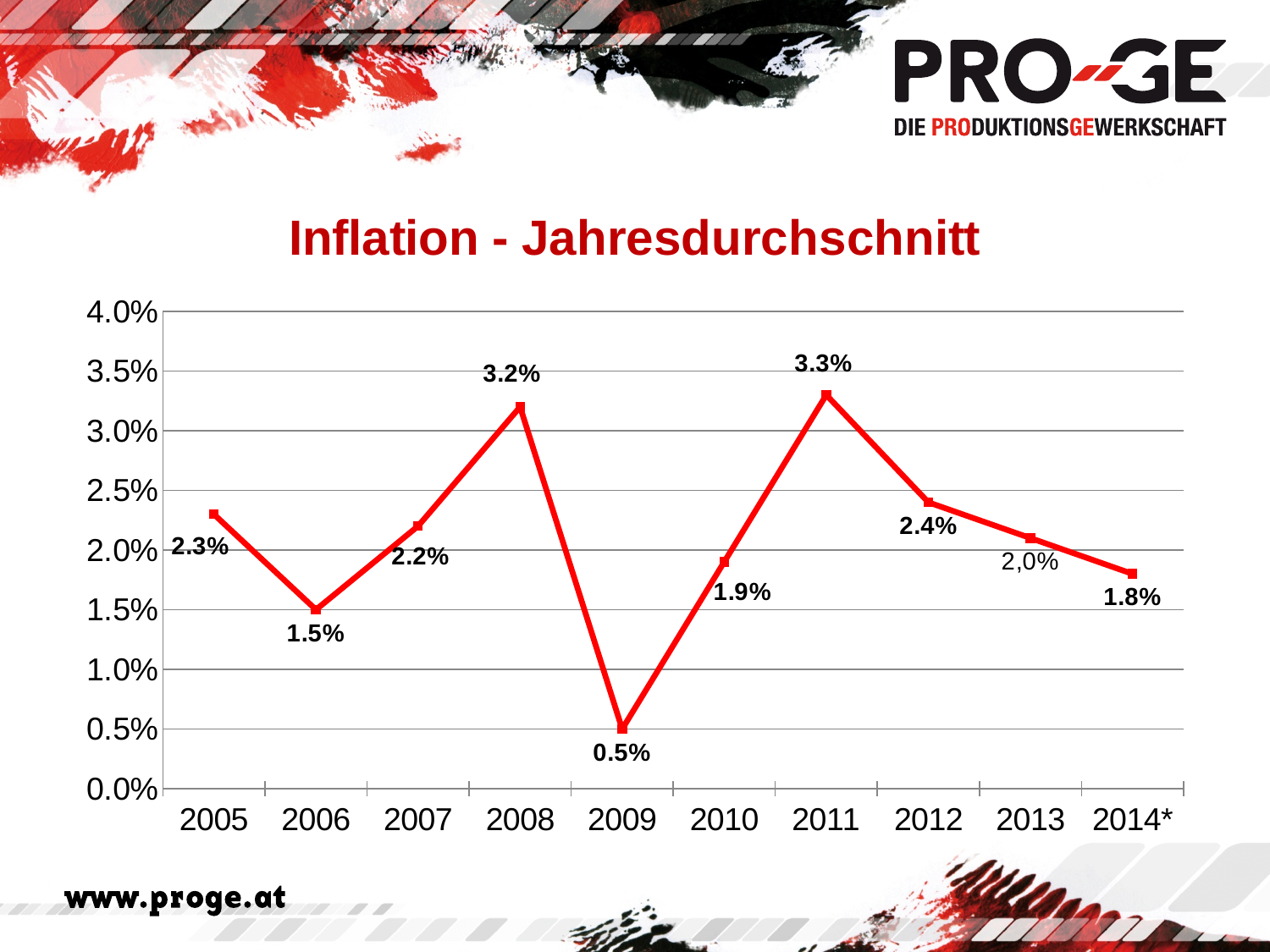
What is the inflation value for 2009? 0.5% Which year has the lowest inflation value? 2009 What kind of chart is shown on the slide? line chart Is the inflation value for 2007 greater or less than 2.0%? greater What is the inflation value for 2008? 3.2% What is the inflation value for 2013? 2,0% Which year has the highest inflation value? 2011 What is the title of the chart? Inflation - Jahresdurchschnitt What is the difference between the inflation values for 2011 and 2012? 0.9% What is the inflation value for 2014*? 1.8% Which year has the larger inflation value, 2006 or 2010? 2010 How many years are plotted on the chart? 10